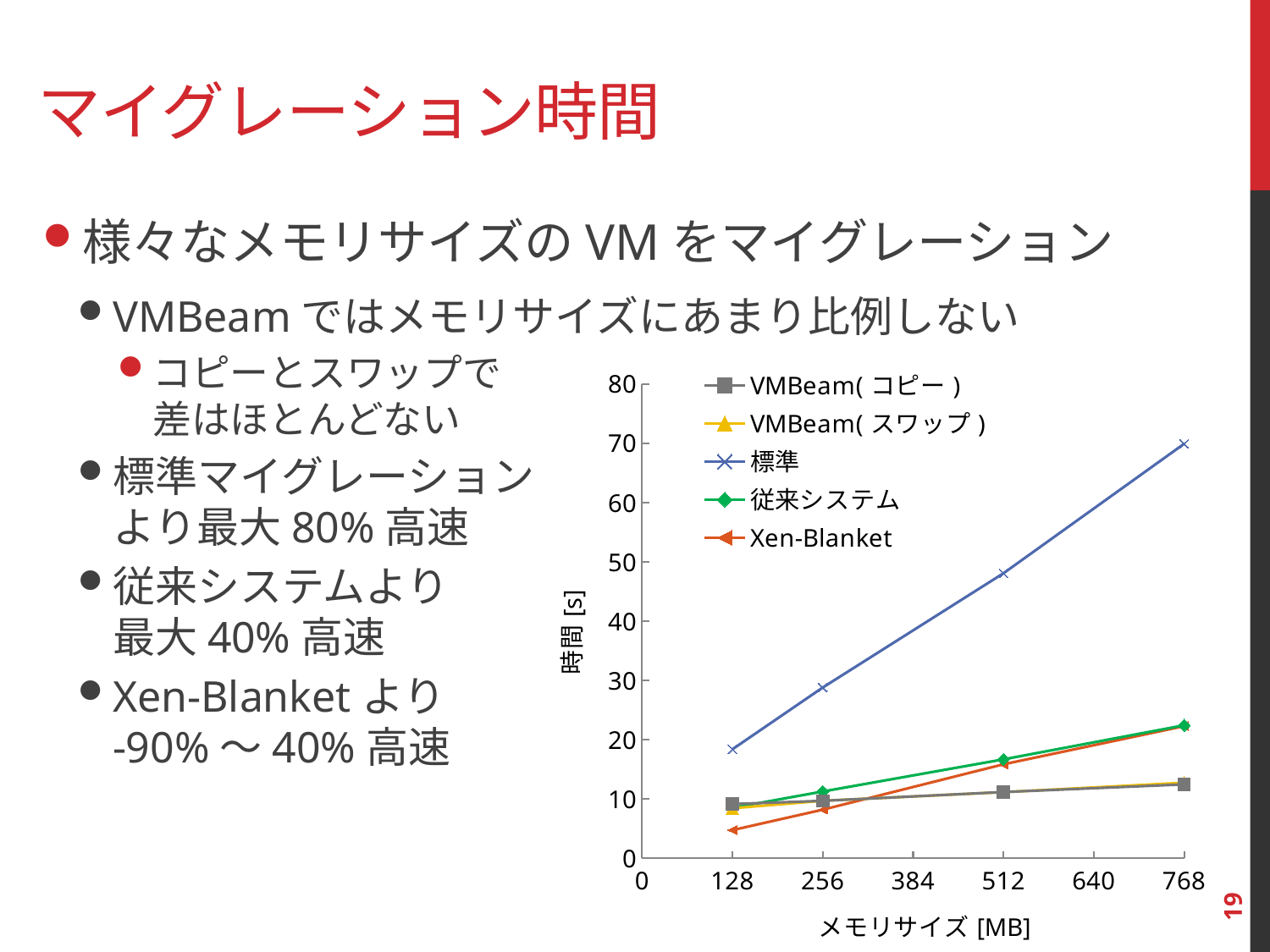
What kind of chart is shown on the slide? line chart Is the value for 標準 at 128 MB greater or less than 20? less How many data points are plotted for the 標準 series? 4 What is the label of the x axis? メモリサイズ [MB] What is the label of the y axis? 時間 [s] Which series has the highest value at 768 MB? 標準 Is the value for 標準 at 768 MB greater or less than 60? greater Is the value for Xen-Blanket at 128 MB greater or less than 10? less Which is larger at 512 MB, the value for 標準 or the value for VMBeam( コピー )? 標準 Does the 標準 series rise or fall as memory size increases along the x axis? rise How many series does the legend list? 5 Which series has the lowest value at 128 MB? Xen-Blanket